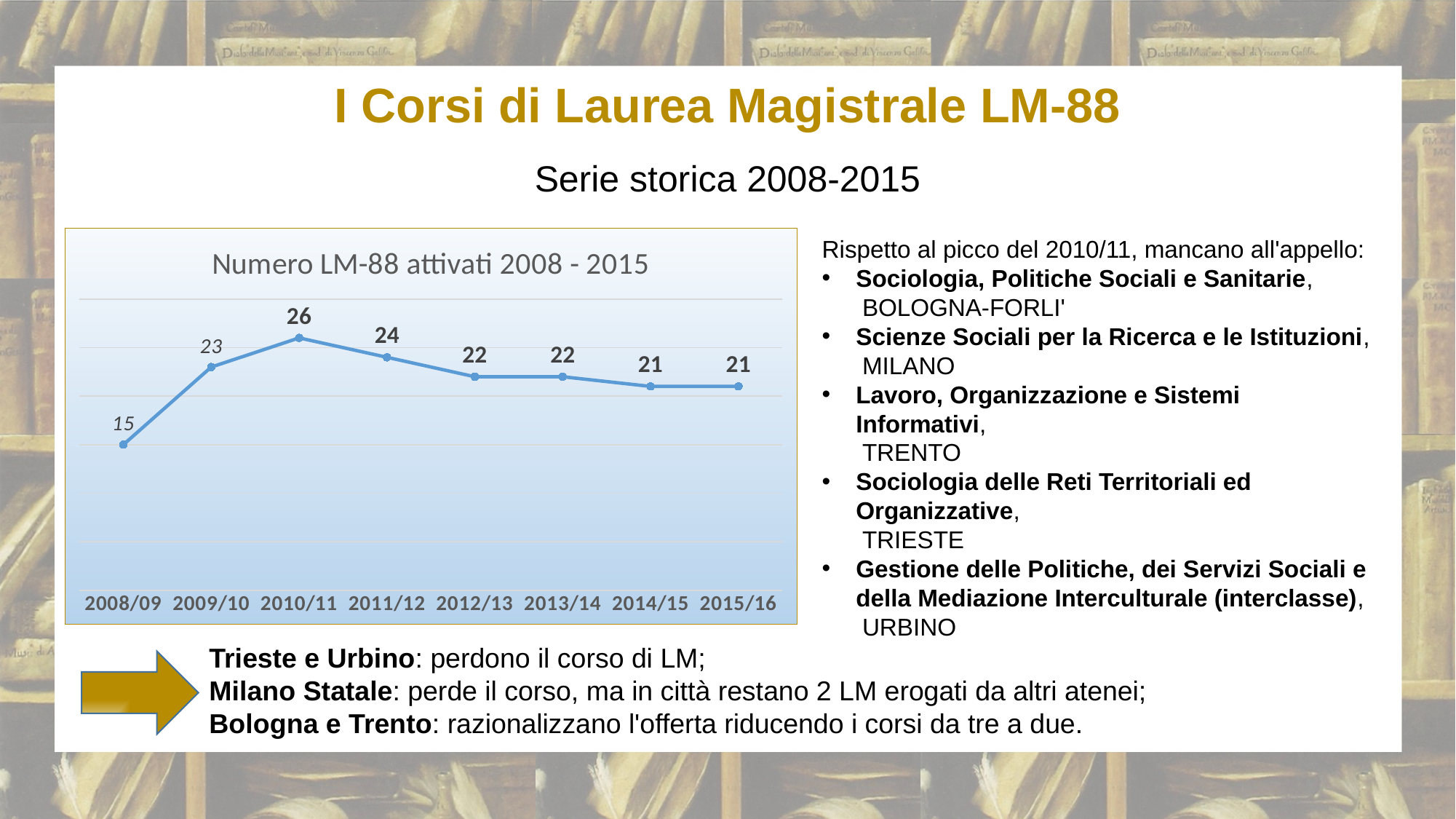
How many data points are plotted in the chart? 8 What is the title of the chart? Numero LM-88 attivati 2008 - 2015 What is the difference between the values for 2009/10 and 2008/09? 8 What kind of chart is shown on the slide? line chart What is the value for 2010/11 in the chart? 26 Which is larger, the value for 2011/12 or the value for 2013/14? 2011/12 What is the value for 2015/16 in the chart? 21 What is the difference between the values for 2010/11 and 2015/16? 5 What is the value for 2011/12 in the chart? 24 Which year has the lowest value in the chart? 2008/09 Which year has the highest value in the chart? 2010/11 What is the value for 2008/09 in the chart? 15